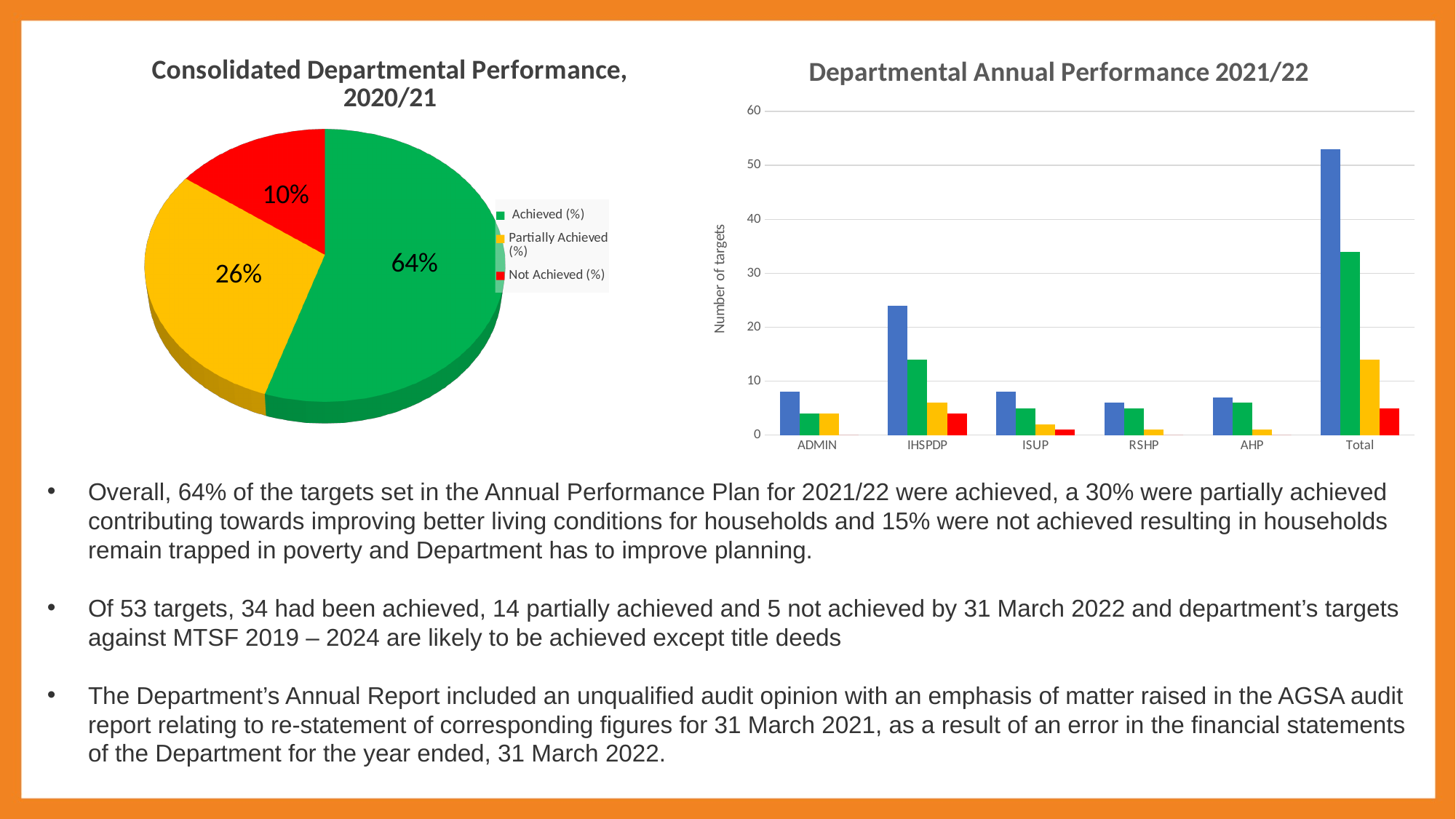
In the bar chart 'Departmental Annual Performance 2021/22', is the blue bar for Total greater or less than 50? greater In the pie chart 'Consolidated Departmental Performance, 2020/21', which category has the largest share? Achieved (%) In the bar chart 'Departmental Annual Performance 2021/22', what is the label of the y axis? Number of targets In the pie chart 'Consolidated Departmental Performance, 2020/21', which category has the smallest share? Not Achieved (%) What kind of chart is 'Departmental Annual Performance 2021/22'? Bar chart What kind of chart is 'Consolidated Departmental Performance, 2020/21'? Pie chart In the pie chart 'Consolidated Departmental Performance, 2020/21', how many entries does the legend list? 3 In the pie chart 'Consolidated Departmental Performance, 2020/21', what is the difference in percentage points between Achieved and Partially Achieved? 38 In the pie chart 'Consolidated Departmental Performance, 2020/21', what percentage was Partially Achieved? 26% In the pie chart 'Consolidated Departmental Performance, 2020/21', what percentage was Achieved? 64% In the bar chart 'Departmental Annual Performance 2021/22', how many categories are shown on the x axis? 6 In the pie chart 'Consolidated Departmental Performance, 2020/21', what percentage was Not Achieved? 10%